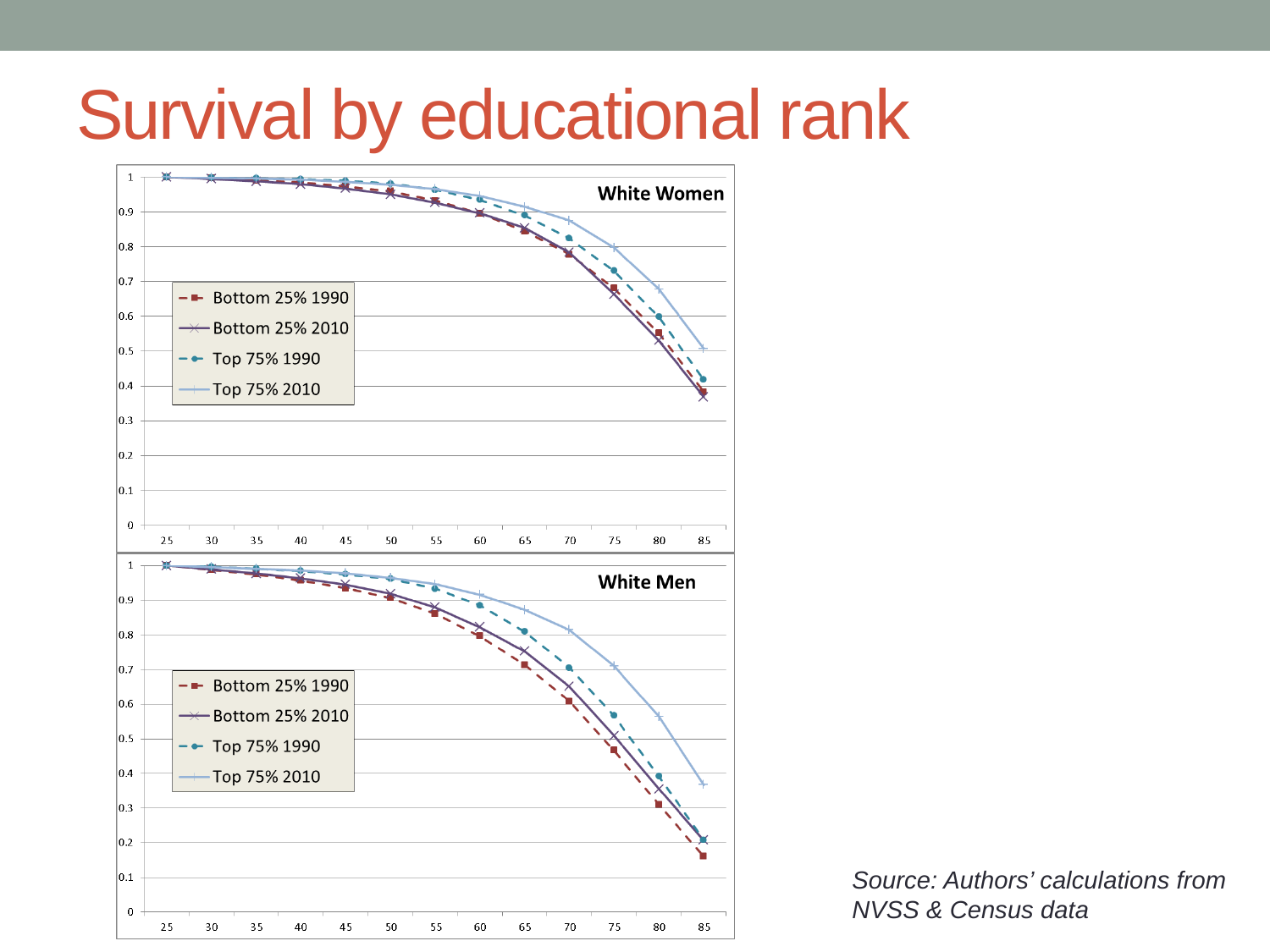
In the White Men chart, is the value for Bottom 25% 1990 at age 75 greater or less than 0.6? less In the White Men chart, is the value for Bottom 25% 1990 at age 85 greater or less than 0.2? less What is the title of the lower chart on the slide? White Men In the White Women chart, at age 85, which is larger: Top 75% 2010 or Bottom 25% 1990? Top 75% 2010 How many series does the legend of the White Men chart list? 4 In the White Women chart, is the value for Bottom 25% 1990 at age 65 greater or less than 0.8? greater In the White Men chart, which series has the highest value at age 85? Top 75% 2010 What kind of chart is the White Women chart? line chart How many age points are marked along the x axis of the White Women chart? 13 In the White Men chart, which series has the lowest value at age 85? Bottom 25% 1990 In the White Men chart, do the survival values rise or fall as age increases along the x axis? fall